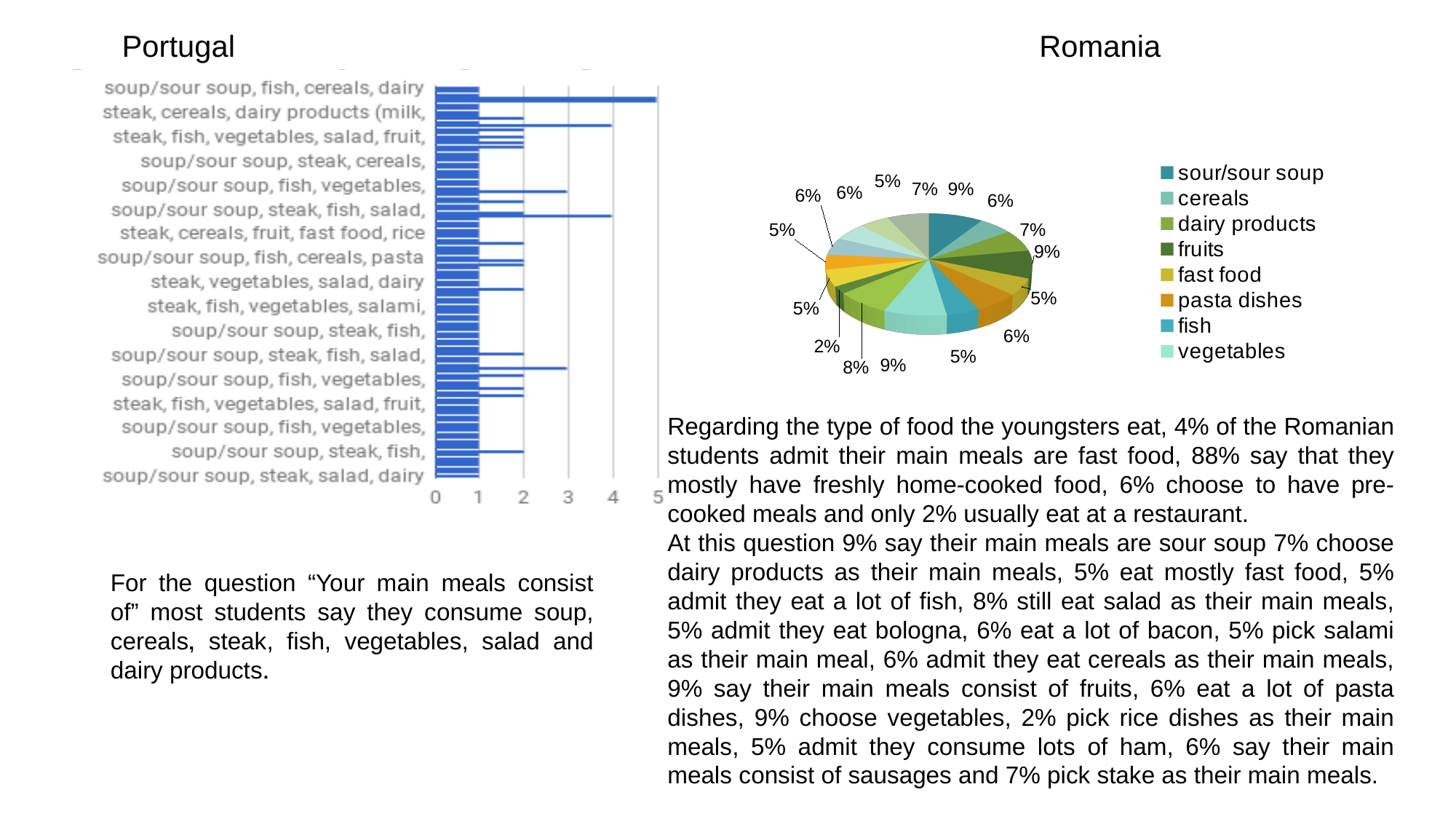
In the Portugal chart, what is the highest value marked on the horizontal axis? 5 In the Romania chart, what percentage is shown for vegetables? 9% In the Portugal chart, is the longest bar greater or less than 4? greater In the Romania chart, what percentage is shown for fish? 5% In the Romania chart, which is larger, the share for fruits or the share for fast food? fruits In the Romania chart, what is the smallest percentage labelled on any slice? 2% In the Romania chart, how many entries does the legend list? 8 What kind of chart is the Romania chart? pie chart In the Romania chart, what is the difference between the share for fruits and the share for fast food? 4 percentage points In the Romania chart, what percentage is shown for fruits? 9% In the Romania chart, what percentage is shown for sour/sour soup? 9% What kind of chart is the Portugal chart? bar chart